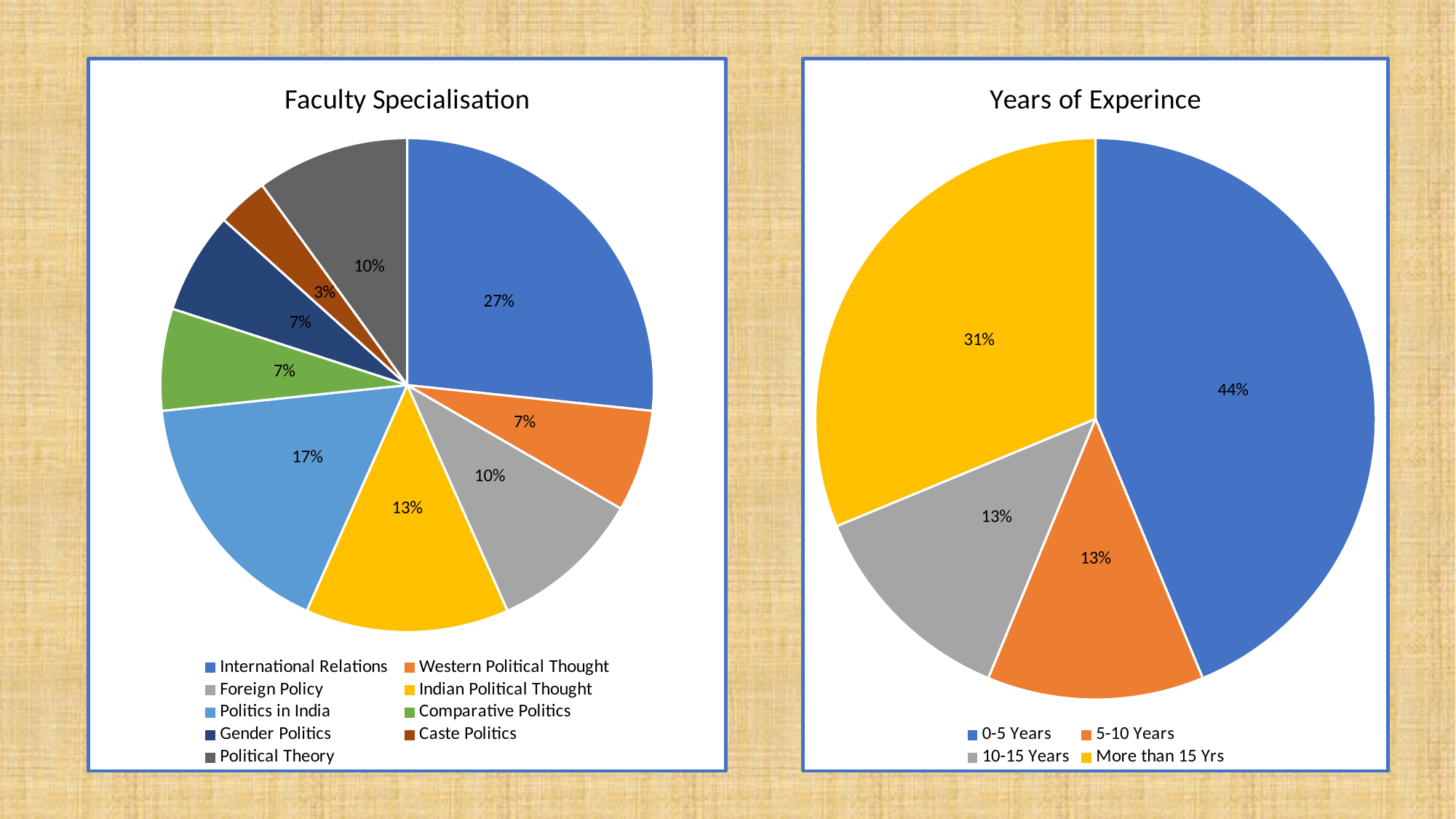
In the Faculty Specialisation chart, which has a larger share, Politics in India or Political Theory? Politics in India In the Years of Experince chart, how many categories are shown? 4 In the Faculty Specialisation chart, what is the difference between the shares of Indian Political Thought and Foreign Policy? 3% In the Years of Experince chart, what is the difference between the shares of 0-5 Years and More than 15 Yrs? 13% In the Faculty Specialisation chart, what share does Politics in India have? 17% What type of chart is the Years of Experince chart? Pie chart In the Faculty Specialisation chart, which specialisation has the largest share? International Relations In the Faculty Specialisation chart, which specialisation has the smallest share? Caste Politics In the Years of Experince chart, what share does More than 15 Yrs have? 31% In the Faculty Specialisation chart, how many specialisations are shown? 9 In the Years of Experince chart, what share does 0-5 Years have? 44% In the Faculty Specialisation chart, what share does International Relations have? 27%